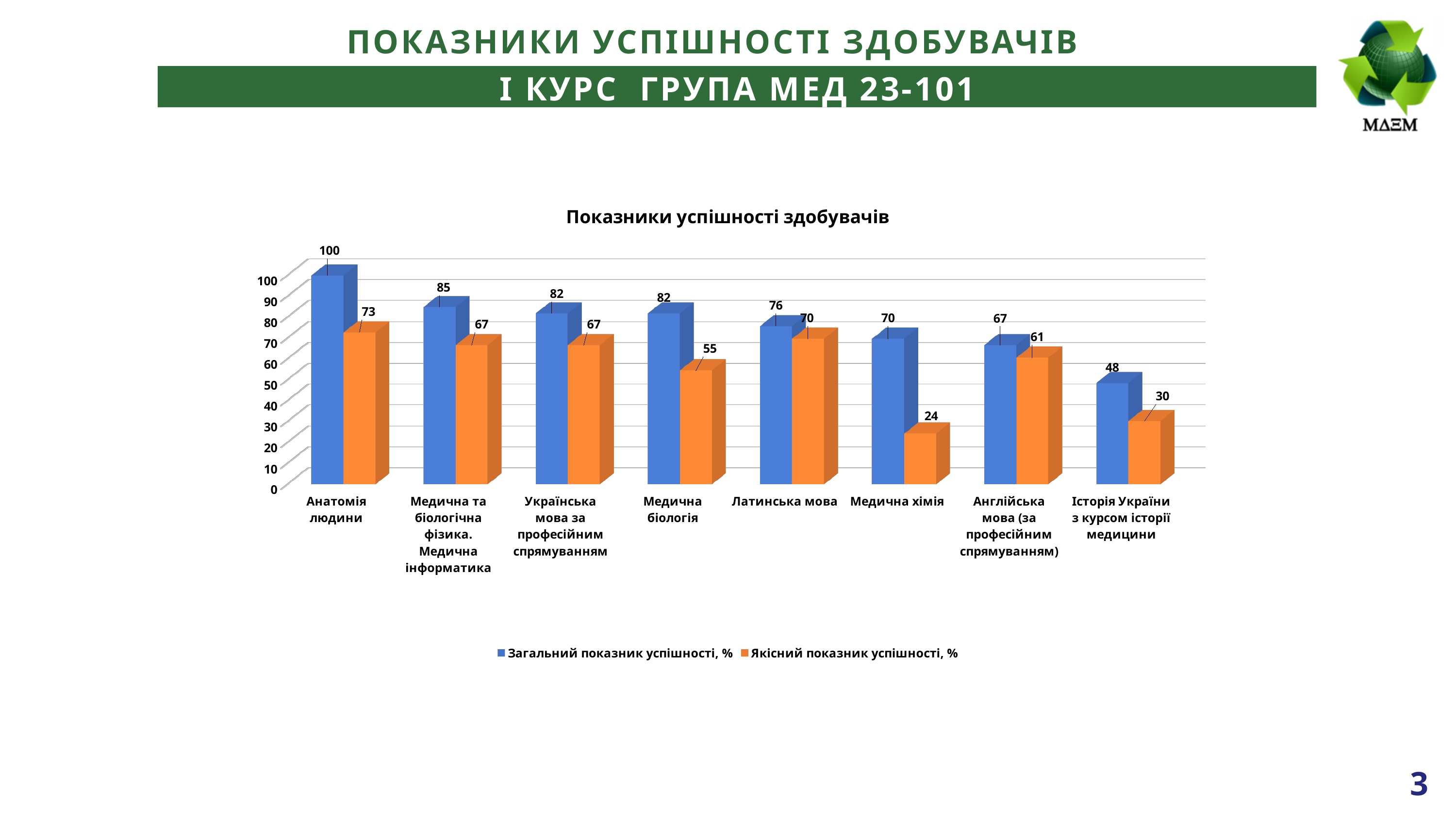
What is the value of "Якісний показник успішності, %" for Медична хімія? 24 What is the value of "Загальний показник успішності, %" for Анатомія людини? 100 What is the title of the chart? Показники успішності здобувачів Which is larger: "Якісний показник успішності, %" for Латинська мова or for Англійська мова (за професійним спрямуванням)? Латинська мова What kind of chart is shown on the slide? Bar chart Which category has the highest value of "Загальний показник успішності, %"? Анатомія людини Which category has the lowest value of "Якісний показник успішності, %"? Медична хімія What is the difference between "Загальний показник успішності, %" and "Якісний показник успішності, %" for Медична хімія? 46 What is the value of "Якісний показник успішності, %" for Медична біологія? 55 How many series does the legend list? 2 How many categories are shown on the x axis of the chart? 8 Do the values of "Загальний показник успішності, %" rise or fall from left to right along the x axis? Fall